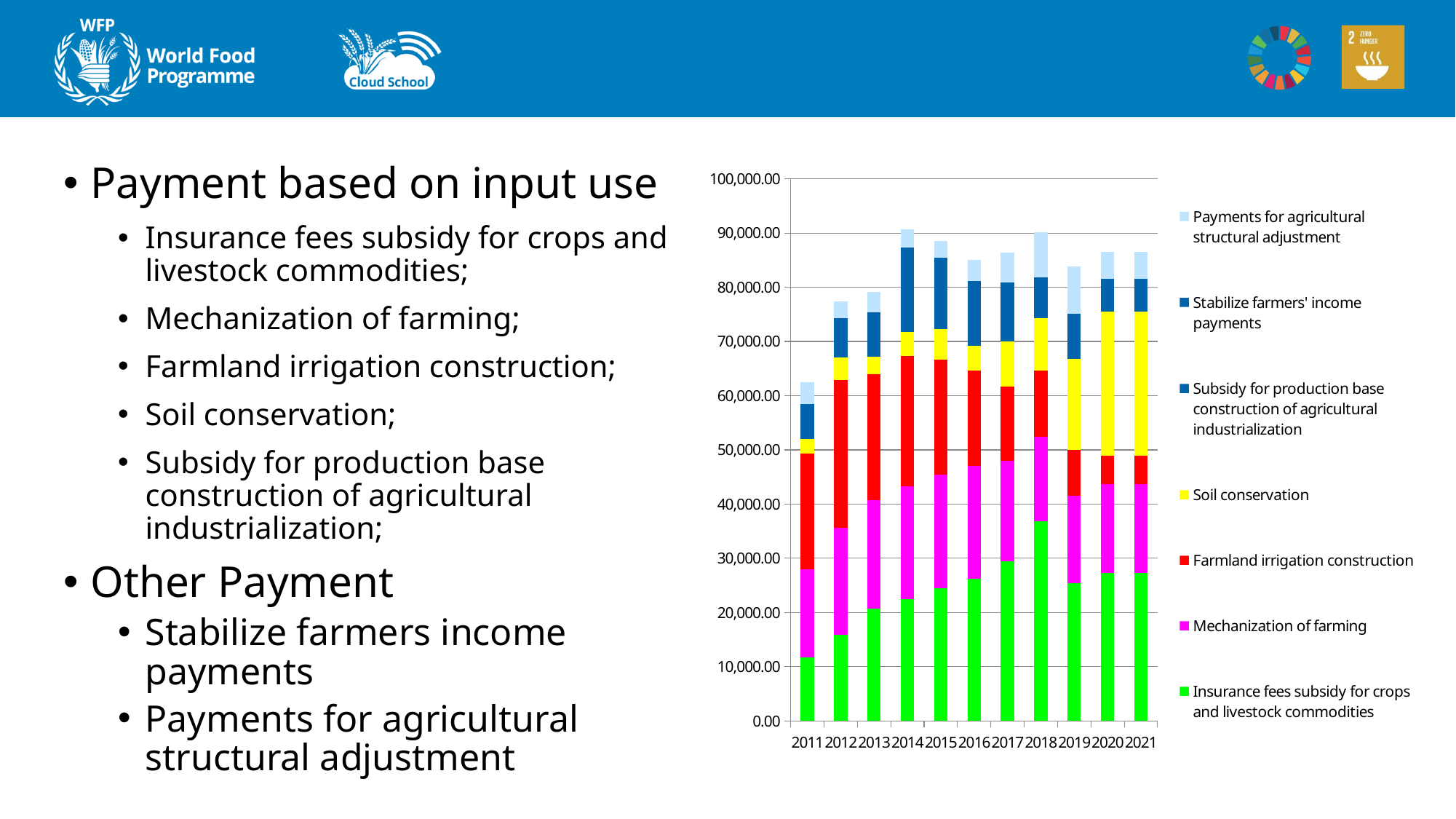
Which year has the lowest total bar height in the chart? 2011 Does the Insurance fees subsidy for crops and livestock commodities segment rise or fall from 2011 to 2018? Rise In which year is the Insurance fees subsidy for crops and livestock commodities segment the largest? 2018 What kind of chart is shown on the slide? Stacked bar chart In which year is the Insurance fees subsidy for crops and livestock commodities segment the smallest? 2011 Is the Insurance fees subsidy for crops and livestock commodities value for 2018 greater or less than 30,000.00? greater How many series does the chart's legend list? 7 Is the total bar value for 2011 greater or less than 60,000.00? greater How many years are shown on the x axis of the chart? 11 Is the Insurance fees subsidy for crops and livestock commodities value for 2011 greater or less than 20,000.00? less What colour represents Soil conservation in the chart's legend? Yellow Which year has the larger total bar, 2011 or 2012? 2012